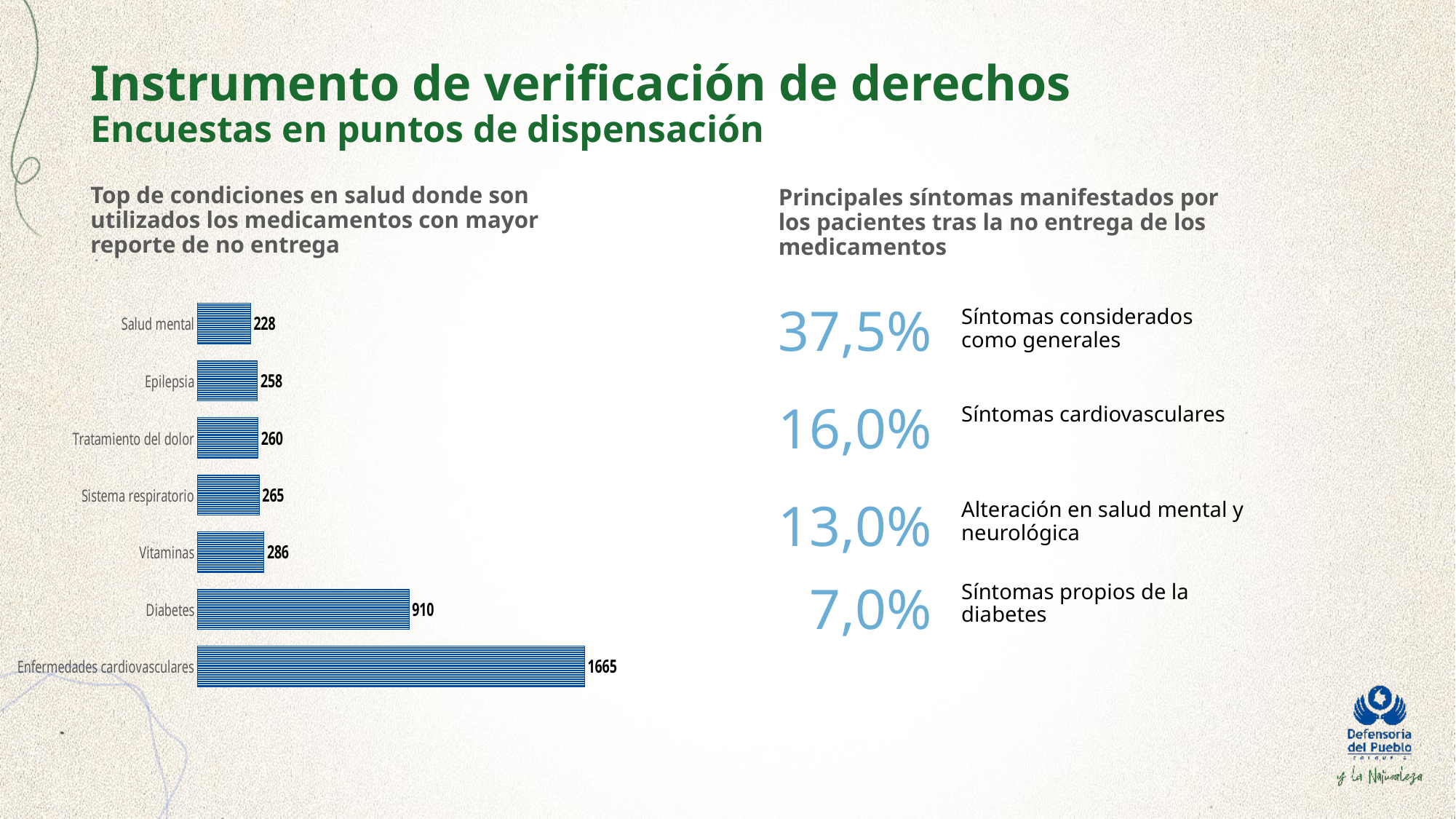
What is the value for Diabetes in the bar chart? 910 How many categories are shown in the bar chart? 7 What is the title of the bar chart on the left of the slide? Top de condiciones en salud donde son utilizados los medicamentos con mayor reporte de no entrega What is the value for Vitaminas in the bar chart? 286 What is the difference between the values for Enfermedades cardiovasculares and Diabetes in the bar chart? 755 What is the value for Sistema respiratorio in the bar chart? 265 What is the value for Salud mental in the bar chart? 228 What kind of chart is shown on the left of the slide? Bar chart What is the difference between the values for Vitaminas and Salud mental in the bar chart? 58 Which category has the highest value in the bar chart? Enfermedades cardiovasculares Which category has the lowest value in the bar chart? Salud mental Which is larger in the bar chart, the value for Diabetes or the value for Vitaminas? Diabetes